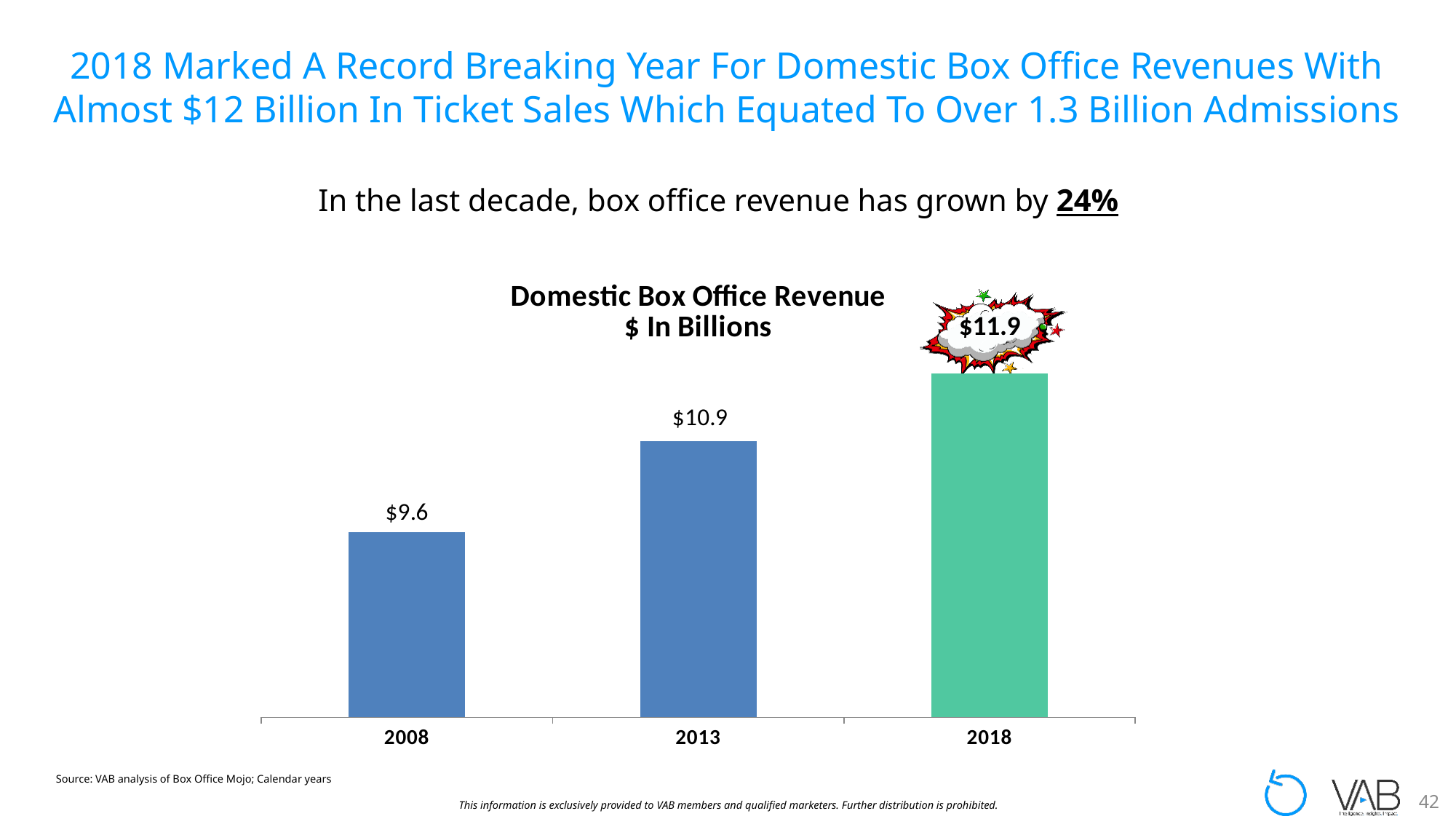
Which year has the lowest domestic box office revenue? 2008 What is the title of the chart? Domestic Box Office Revenue $ In Billions What is the domestic box office revenue shown for 2013? $10.9 Do the domestic box office revenue values rise or fall from 2008 to 2018? Rise What is the difference in domestic box office revenue between 2018 and 2008? $2.3 Which year has the highest domestic box office revenue? 2018 What is the domestic box office revenue shown for 2008? $9.6 What kind of chart is used to show domestic box office revenue? Bar chart What is the domestic box office revenue shown for 2018? $11.9 What is the difference in domestic box office revenue between 2013 and 2008? $1.3 How many years are shown on the chart? 3 Which year has the larger domestic box office revenue, 2013 or 2018? 2018